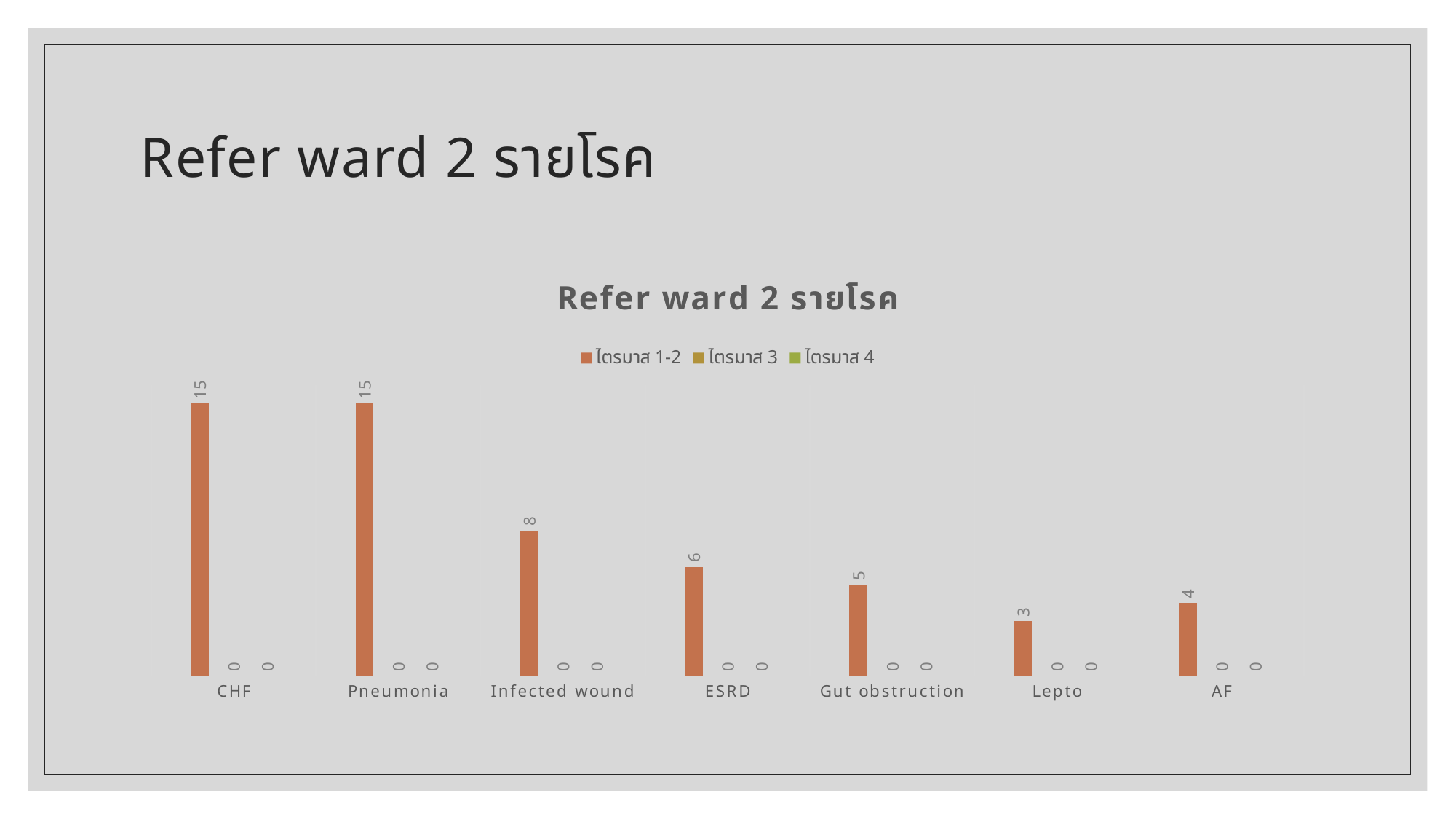
What is the value for AF in the ไตรมาส 3 series? 0 In the ไตรมาส 1-2 series, which is larger: AF or Gut obstruction? Gut obstruction What kind of chart is shown? Bar chart What is the value for Infected wound in the ไตรมาส 1-2 series? 8 Which category has the lowest value in the ไตรมาส 1-2 series? Lepto What is the value for CHF in the ไตรมาส 1-2 series? 15 How many series does the legend list? 3 What is the difference between the ไตรมาส 1-2 values for Infected wound and AF? 4 What is the value for Gut obstruction in the ไตรมาส 1-2 series? 5 What is the difference between the ไตรมาส 1-2 values for Pneumonia and ESRD? 9 How many categories are shown on the x axis? 7 In the ไตรมาส 1-2 series, which is larger: ESRD or Lepto? ESRD